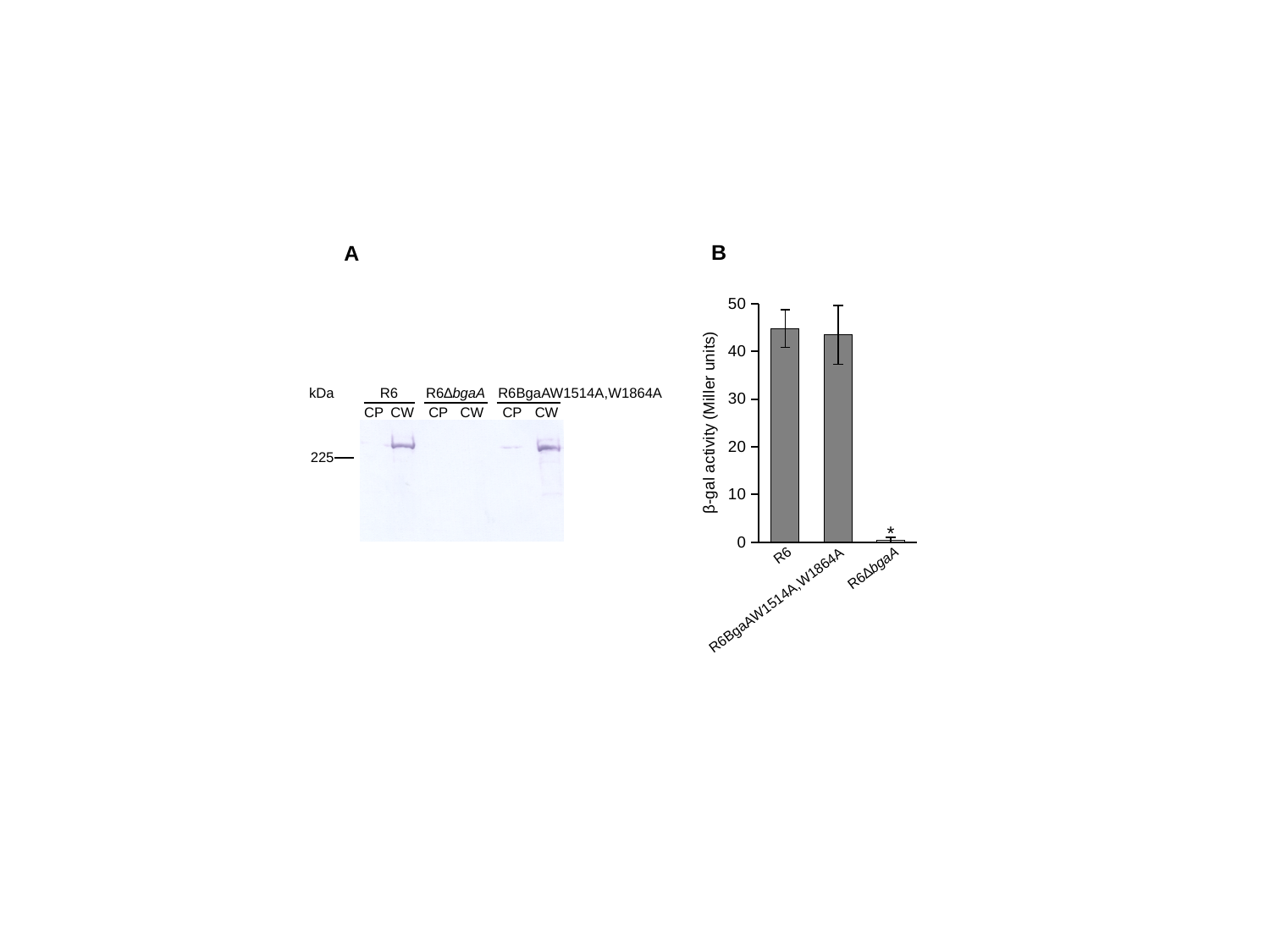
In panel B, which has higher β-gal activity, R6 or R6ΔbgaA? R6 In panel B, is the β-gal activity for R6BgaAW1514A,W1864A greater or less than 30 Miller units? greater In panel B, is the β-gal activity for R6ΔbgaA greater or less than 10 Miller units? less In panel B, what is the highest value shown on the y-axis? 50 In panel B, which category has the lowest β-gal activity? R6ΔbgaA In panel B, which bar is marked with an asterisk? R6ΔbgaA In panel B, how many bars (categories) are plotted? 3 In panel B, is the β-gal activity for R6 greater or less than 40 Miller units? greater In panel B, what kind of chart is shown? bar chart In panel B, what is the label of the y-axis? β-gal activity (Miller units) In panel B, which has higher β-gal activity, R6BgaAW1514A,W1864A or R6ΔbgaA? R6BgaAW1514A,W1864A